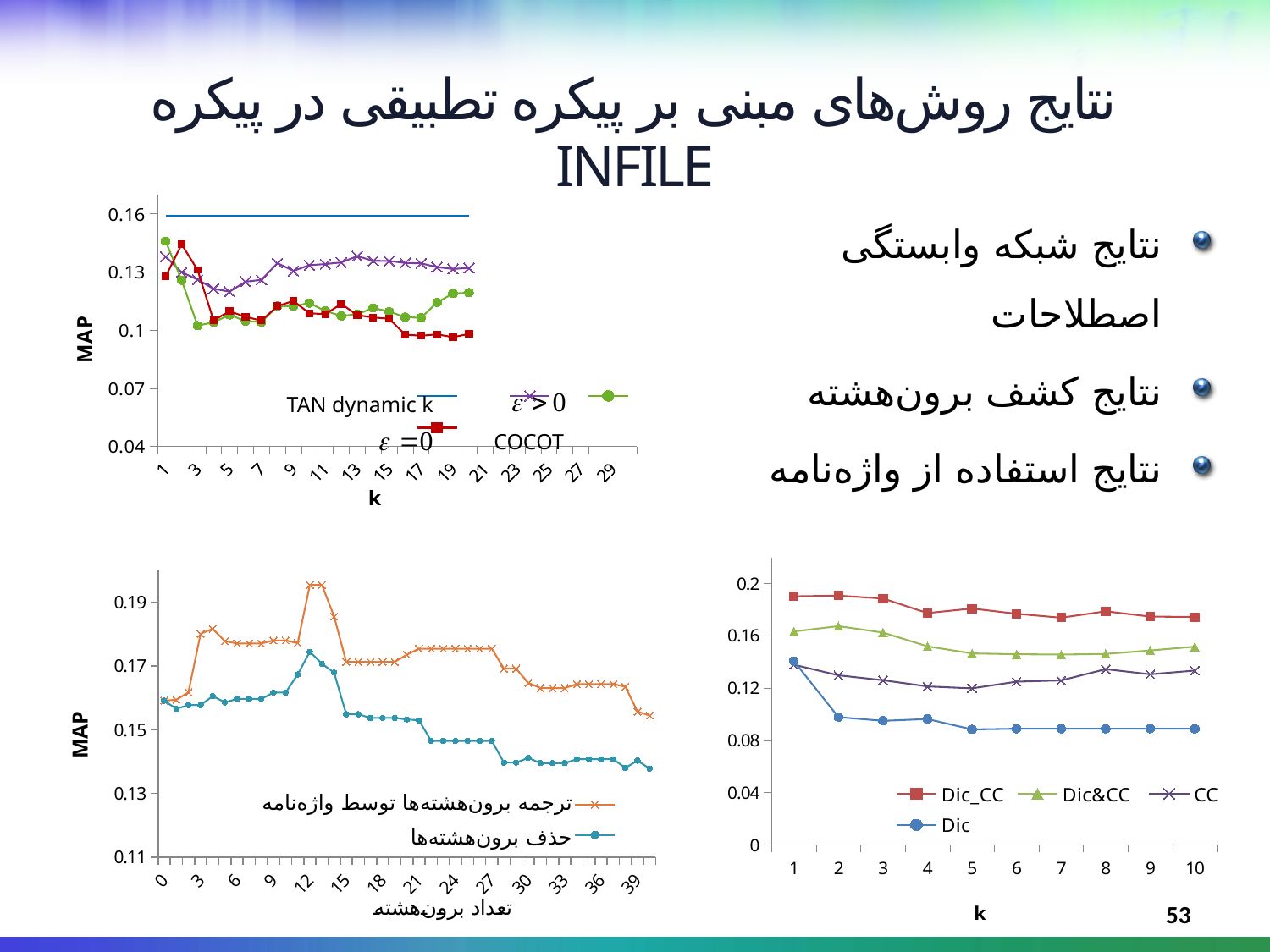
In the bottom-left chart (MAP vs number of outliers), how many series does the legend list? 2 In the bottom-right chart (Dic_CC, Dic&CC, CC, Dic), does the MAP of the Dic series rise or fall from k = 1 to k = 10? fall What kind of chart is the top-left chart (TAN dynamic k, ε>0, ε=0, COCOT)? line chart In the top-left chart (TAN dynamic k, ε>0, ε=0, COCOT), which series has the highest MAP across the plotted k values? TAN dynamic k In the bottom-right chart (Dic_CC, Dic&CC, CC, Dic), which series has the highest MAP across all k values? Dic_CC In the bottom-right chart (Dic_CC, Dic&CC, CC, Dic), which series has the lowest MAP at k = 5? Dic In the bottom-left chart (MAP vs number of outliers), is the peak MAP value of the orange series (ترجمه برون‌هشته‌ها توسط واژه‌نامه) greater or less than 0.19? greater In the bottom-right chart (Dic_CC, Dic&CC, CC, Dic), is the MAP value for Dic_CC at k = 1 greater or less than 0.16? greater In the bottom-right chart (Dic_CC, Dic&CC, CC, Dic), is the MAP value for Dic at k = 5 greater or less than 0.12? less In the bottom-right chart (Dic_CC, Dic&CC, CC, Dic), how many k values are plotted on the x axis? 10 In the bottom-right chart (Dic_CC, Dic&CC, CC, Dic), how many series does the legend list? 4